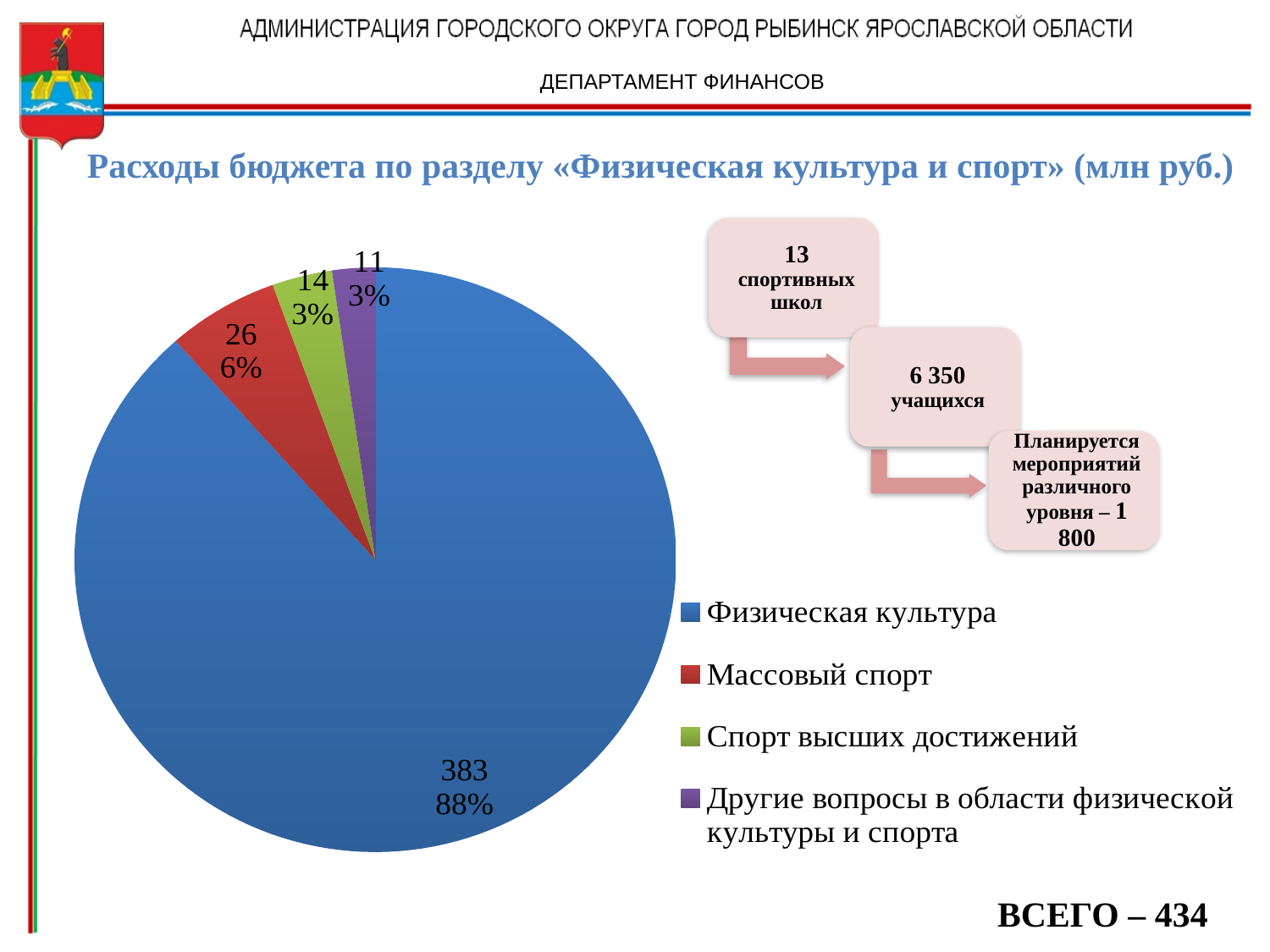
What is the value for «Массовый спорт» in the pie chart? 26 What is the value for «Другие вопросы в области физической культуры и спорта» in the pie chart? 11 What is the value for «Спорт высших достижений» in the pie chart? 14 Which category has the largest slice in the pie chart? Физическая культура What is the difference between the values for «Массовый спорт» and «Спорт высших достижений»? 12 What is the value for «Физическая культура» in the pie chart? 383 Which category has the smallest slice in the pie chart? Другие вопросы в области физической культуры и спорта What share of the pie does «Физическая культура» take? 88% How many categories does the pie chart have? 4 What type of chart is shown on the slide? pie chart What colour is the slice for «Массовый спорт»? red What share of the pie does «Массовый спорт» take? 6%